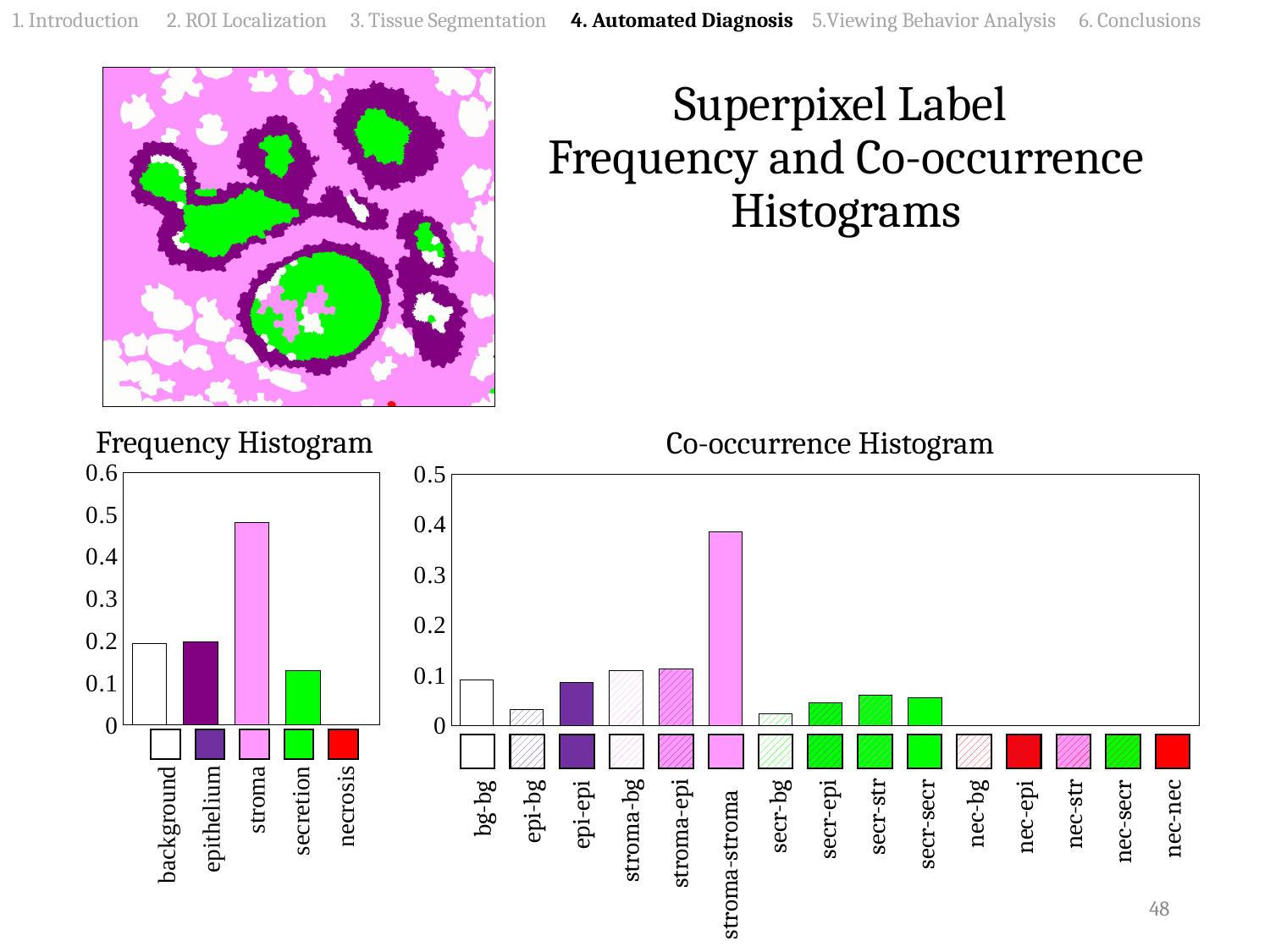
What kind of chart is the Frequency Histogram? bar chart In the Co-occurrence Histogram, which category has the highest value? stroma-stroma In the Co-occurrence Histogram, which is larger, the value for epi-bg or the value for epi-epi? epi-epi In the Frequency Histogram, which is larger, the value for stroma or the value for secretion? stroma In the Frequency Histogram, which category has the lowest value? necrosis In the Frequency Histogram, which category has the highest value? stroma How many categories are shown in the Co-occurrence Histogram? 15 In the Frequency Histogram, is the value for secretion greater or less than 0.2? less In the Co-occurrence Histogram, is the value for bg-bg greater or less than 0.1? less How many categories are shown in the Frequency Histogram? 5 In the Co-occurrence Histogram, is the value for stroma-stroma greater or less than 0.3? greater